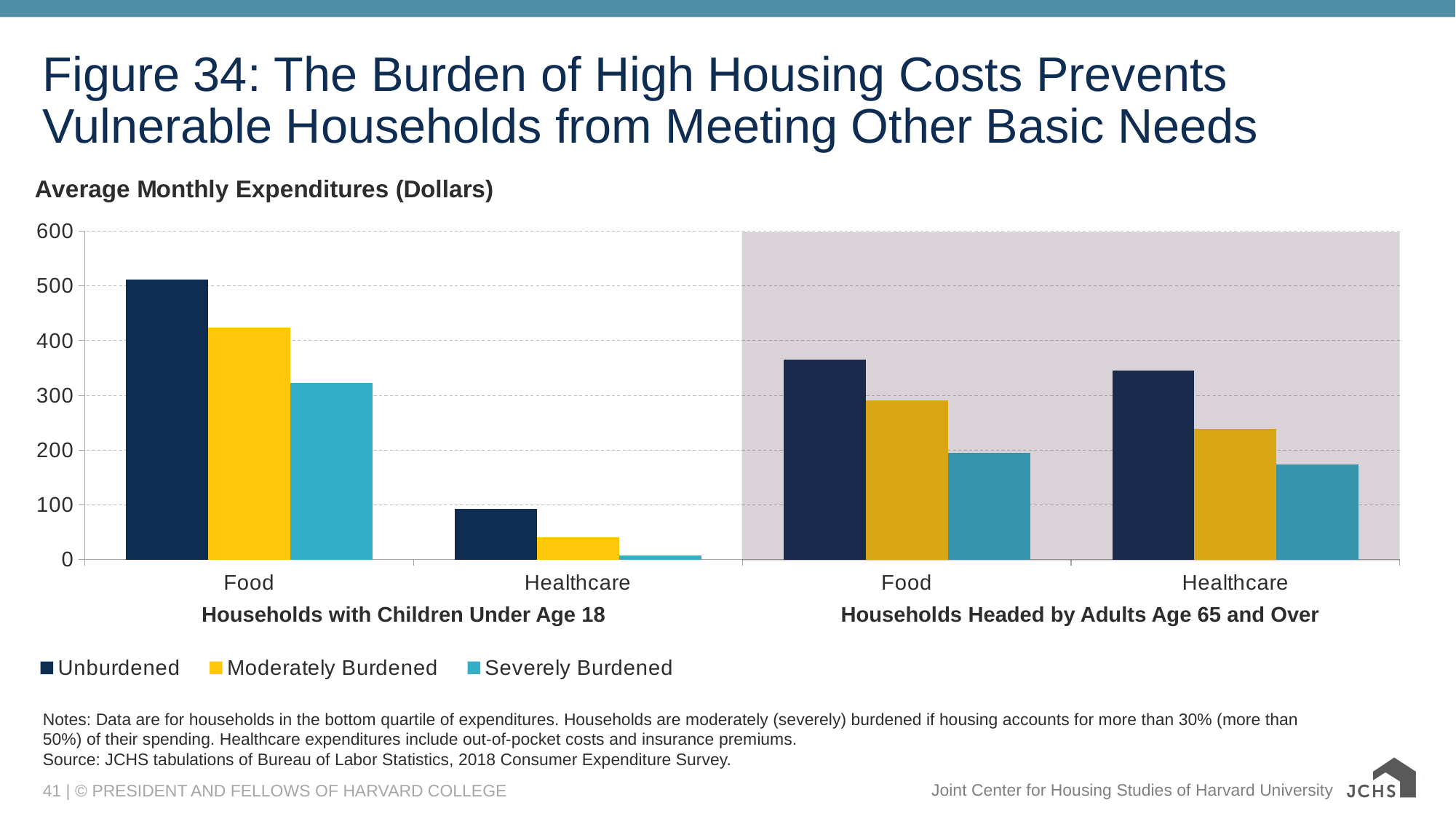
Is the Severely Burdened Healthcare value for Households Headed by Adults Age 65 and Over greater or less than 200? less Which series has the lowest Healthcare expenditure for Households with Children Under Age 18? Severely Burdened Which series has the highest Food expenditure for Households with Children Under Age 18? Unburdened What is the axis title shown above the chart? Average Monthly Expenditures (Dollars) Is the Moderately Burdened Food value for Households Headed by Adults Age 65 and Over greater or less than 300? less What kind of chart is shown on the slide? bar chart Is the Unburdened Healthcare value for Households with Children Under Age 18 greater or less than 100? less How many series does the legend list? 3 For Households Headed by Adults Age 65 and Over, is the Unburdened Food value larger or the Unburdened Healthcare value? Food Which is larger: the Unburdened Food value for Households with Children Under Age 18 or the Unburdened Food value for Households Headed by Adults Age 65 and Over? Households with Children Under Age 18